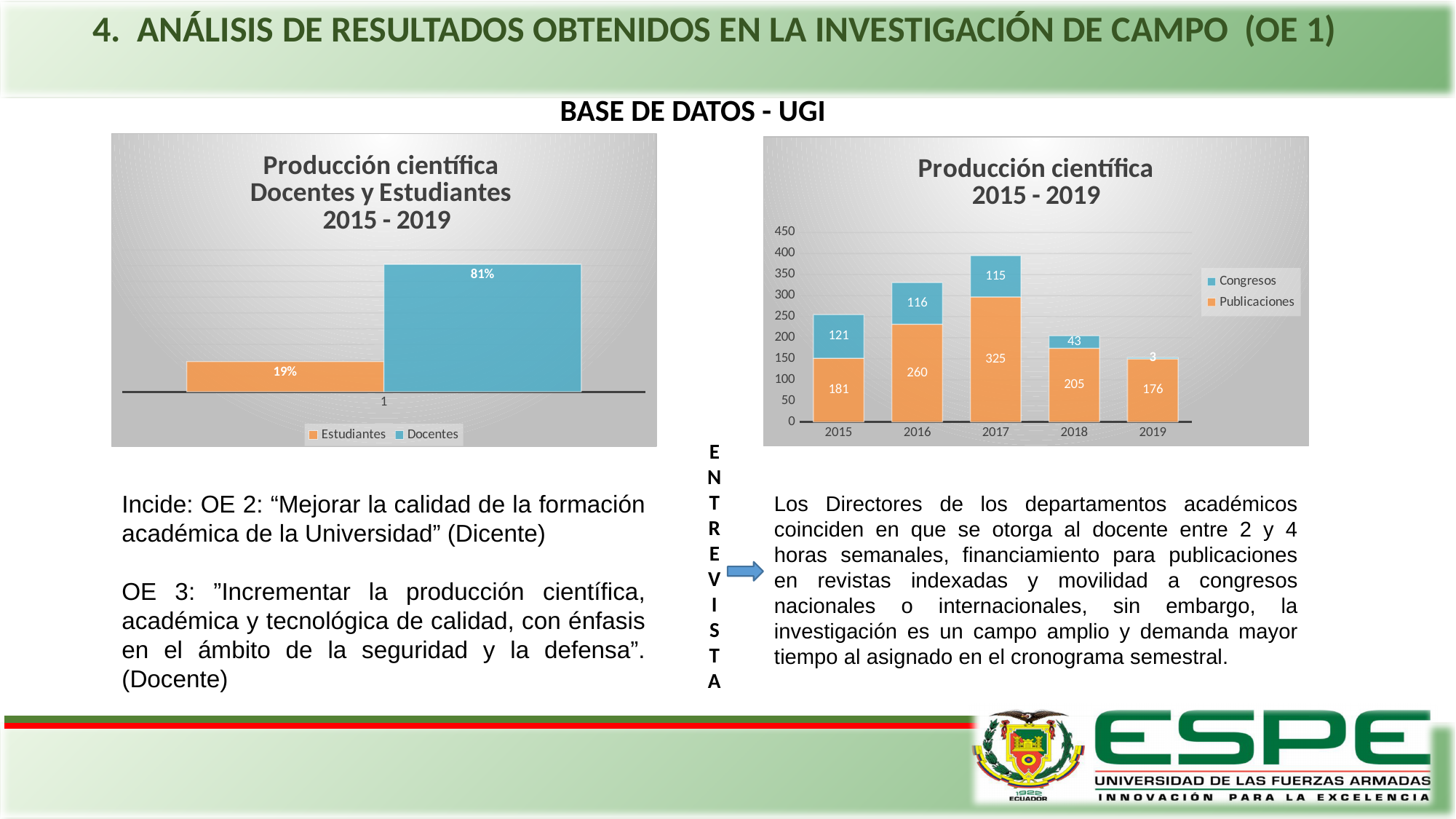
On the right chart 'Producción científica 2015 - 2019', what is the Publicaciones value for 2017? 325 On the right chart 'Producción científica 2015 - 2019', which colour represents Congresos in the legend? Blue On the right chart 'Producción científica 2015 - 2019', which year has the highest Publicaciones value? 2017 On the right chart 'Producción científica 2015 - 2019', how many years are shown on the x axis? 5 On the left chart 'Producción científica Docentes y Estudiantes 2015 - 2019', what is the value for Docentes? 81% On the right chart 'Producción científica 2015 - 2019', what kind of chart is it? Stacked bar chart On the left chart 'Producción científica Docentes y Estudiantes 2015 - 2019', what is the value for Estudiantes? 19% On the left chart 'Producción científica Docentes y Estudiantes 2015 - 2019', how many series does the legend list? 2 On the right chart 'Producción científica 2015 - 2019', which year has the lowest Congresos value? 2019 On the left chart 'Producción científica Docentes y Estudiantes 2015 - 2019', which series has the larger value, Estudiantes or Docentes? Docentes On the right chart 'Producción científica 2015 - 2019', what is the difference between the Publicaciones values for 2016 and 2015? 79 On the right chart 'Producción científica 2015 - 2019', what is the Congresos value for 2018? 43